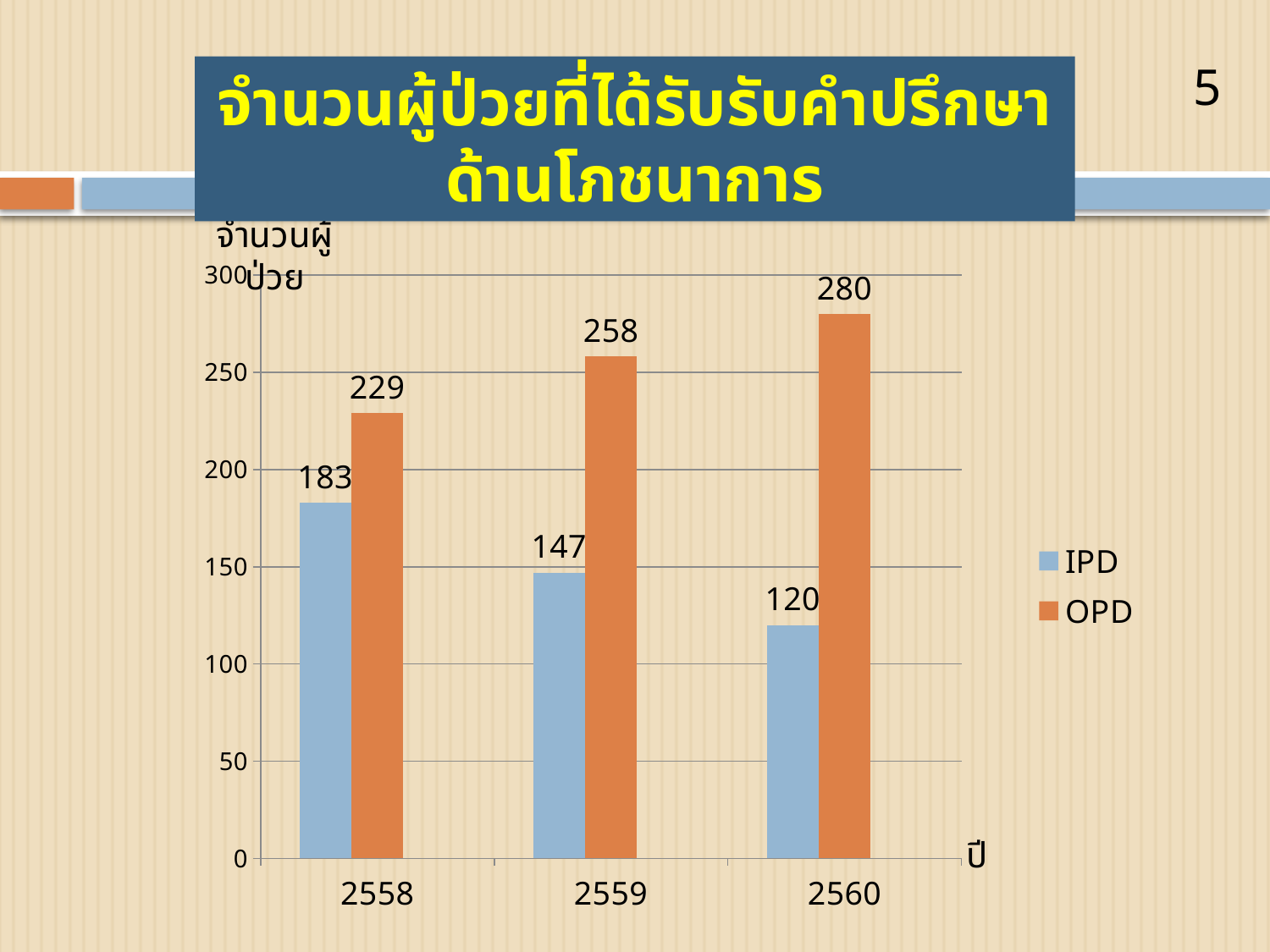
How many years are shown on the x axis? 3 Do the IPD values rise or fall from 2558 to 2560? Fall Which series is shown in orange in the legend? OPD What is the IPD value for 2558? 183 What is the difference between the OPD and IPD values in 2559? 111 Which is larger in 2558, the IPD value or the OPD value? OPD What kind of chart is shown on the slide? Bar chart Which year has the highest OPD value? 2560 What is the OPD value for 2560? 280 What is the OPD value for 2559? 258 How many series does the legend list? 2 Which year has the lowest IPD value? 2560